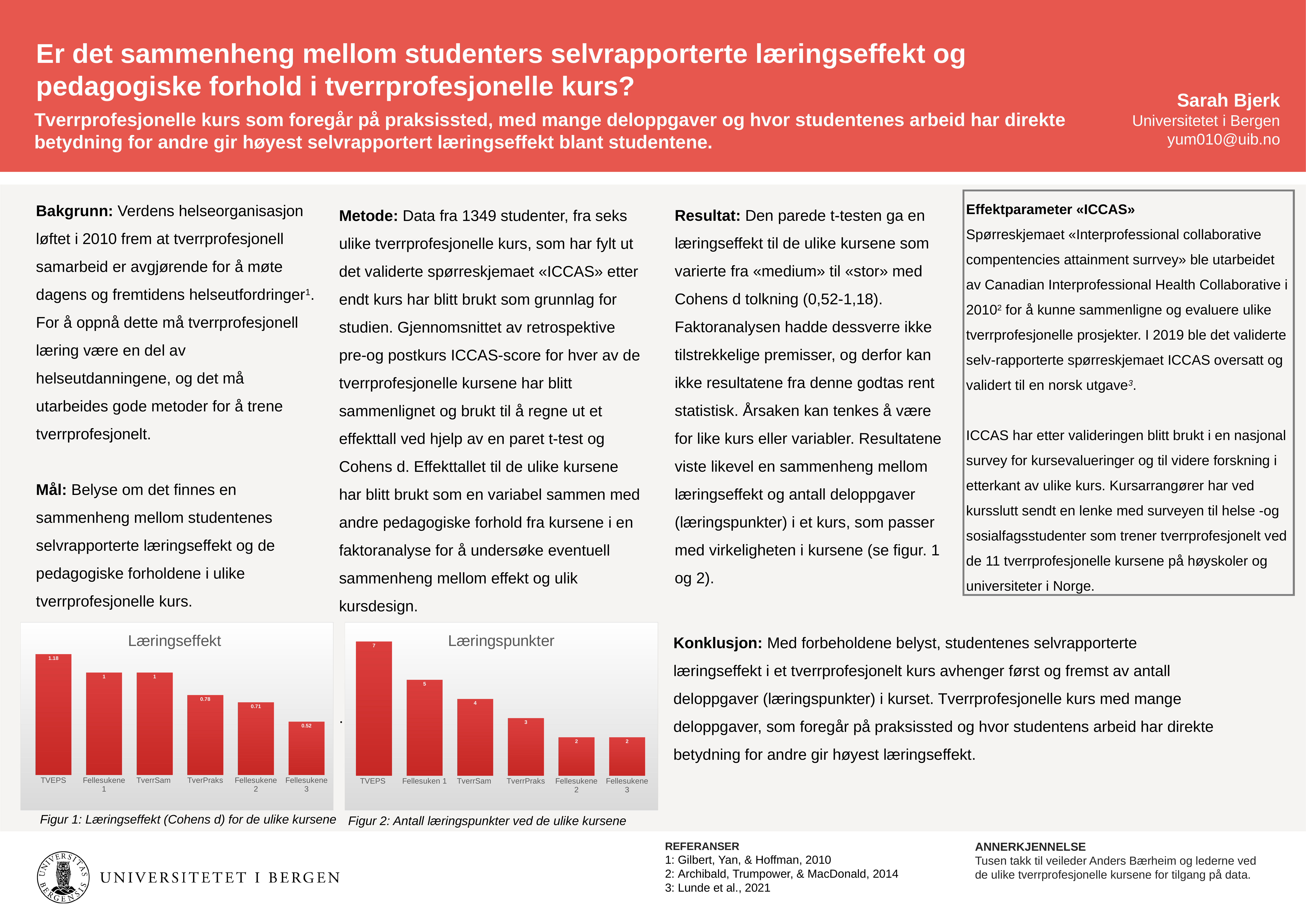
In the Læringspunkter chart, which is larger, the value for TverrPraks or the value for Fellesukene 2? TverrPraks What kind of chart is the Læringspunkter chart? bar chart In the Læringspunkter chart, what is the difference between the values for TVEPS and Fellesuken 1? 2 In the Læringspunkter chart, what is the value for TverrSam? 4 In the Læringspunkter chart, do the values rise or fall from left to right across the categories? fall In the Læringseffekt chart, what is the value for TVEPS? 1.18 In the Læringseffekt chart, which category has the lowest value? Fellesukene 3 In the Læringseffekt chart, what is the difference between the values for TverPraks and Fellesukene 2? 0.07 In the Læringseffekt chart, how many categories are shown? 6 In the Læringseffekt chart, which category has the highest value? TVEPS In the Læringseffekt chart, what is the value for Fellesukene 3? 0.52 In the Læringspunkter chart, what is the value for TVEPS? 7